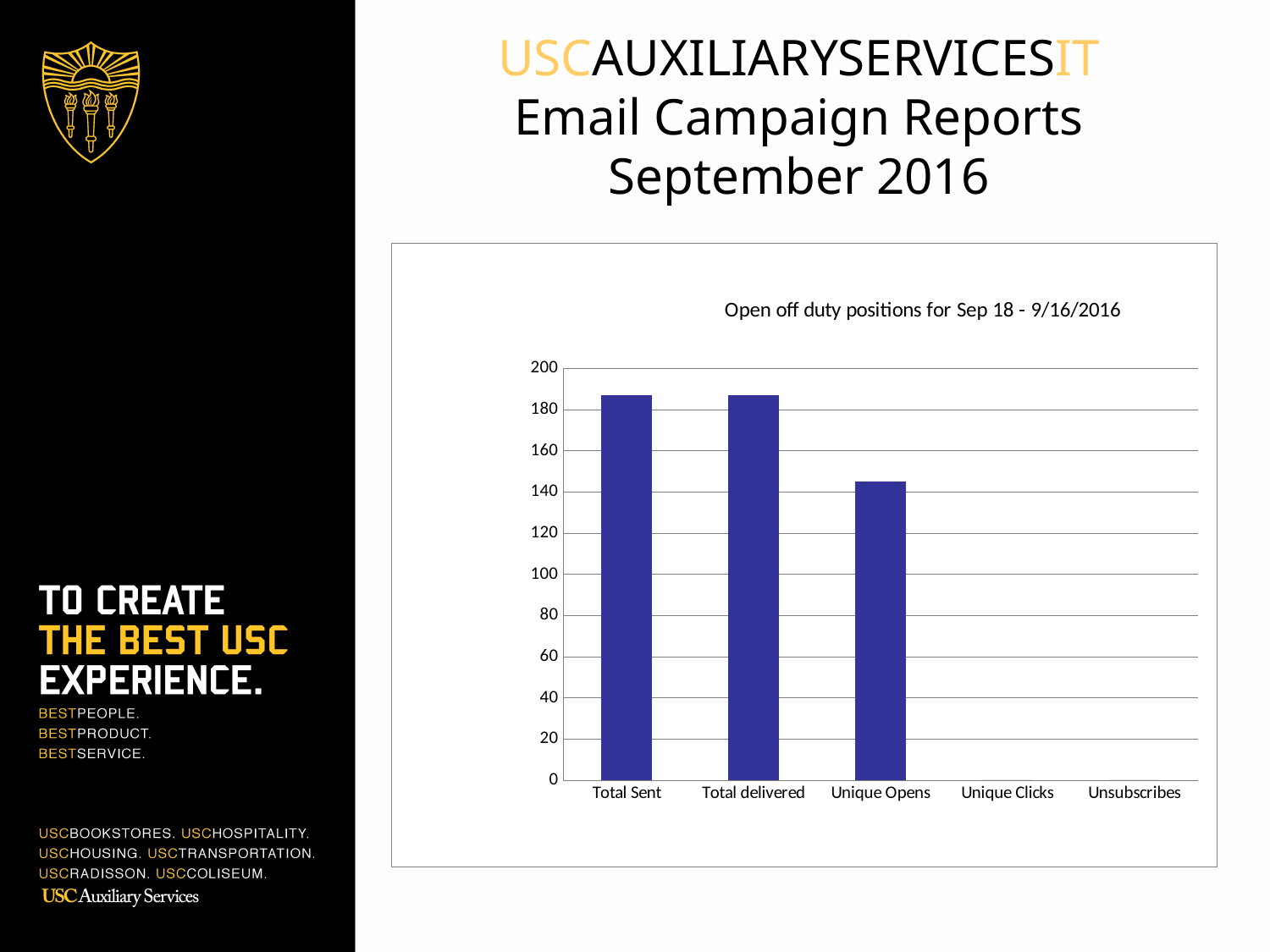
Is the value for Total delivered greater or less than 160? greater Is the value for Unsubscribes greater or less than 20? less Is the value for Unique Clicks greater or less than 20? less Which is larger, the value for Total Sent or the value for Unique Opens? Total Sent Which is larger, the value for Unique Opens or the value for Unique Clicks? Unique Opens What kind of chart is shown on the slide? bar chart Do the values generally rise or fall moving from left to right along the x axis? fall How many categories are shown on the x axis of the chart? 5 What is the title of the chart? Open off duty positions for Sep 18 - 9/16/2016